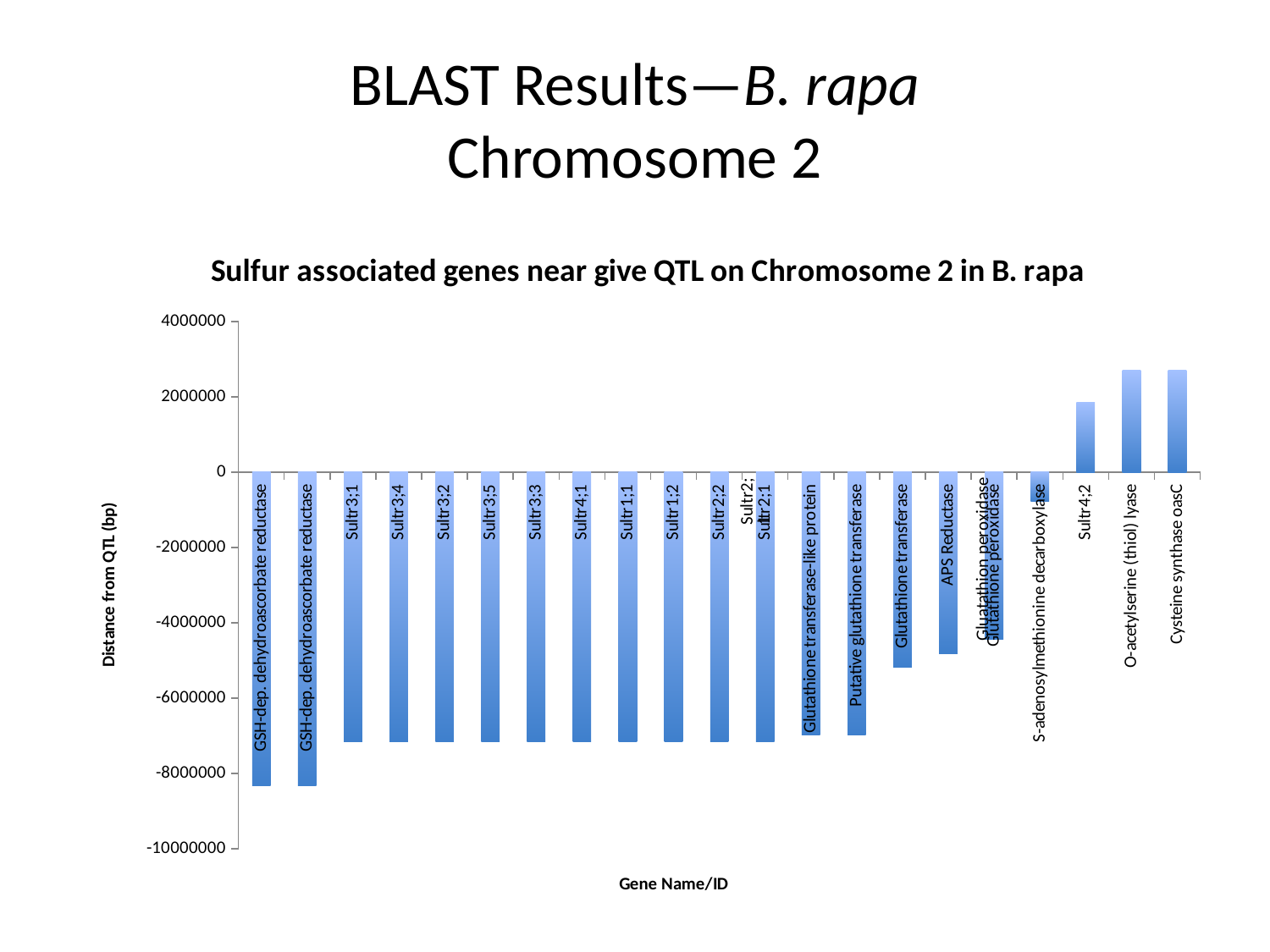
Is the value for Sultr3;1 greater or less than -8000000? greater What is the label of the vertical axis? Distance from QTL (bp) Is the value for APS Reductase greater or less than -4000000? less Which has the larger value, Cysteine synthase oasC or Sultr4;2? Cysteine synthase oasC Is the value for S-adenosylmethionine decarboxylase greater or less than -2000000? greater Which has the larger value, Putative glutathione transferase or Sultr2;2? Putative glutathione transferase Which has the larger value, APS Reductase or Sultr3;1? APS Reductase What kind of chart is shown on the slide? bar chart What is the title of the chart? Sulfur associated genes near give QTL on Chromosome 2 in B. rapa